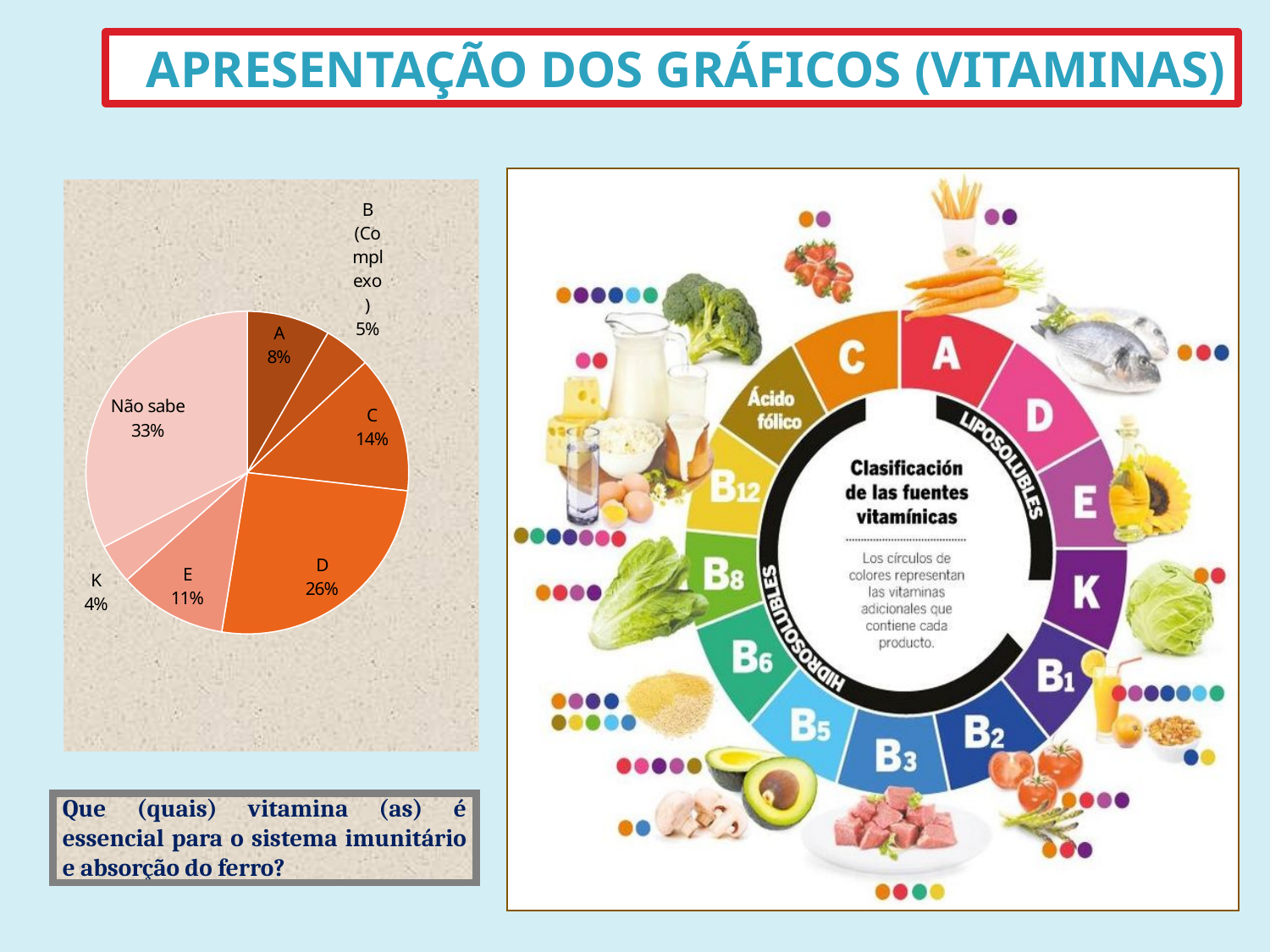
How many slices does the pie chart have? 7 Which slice of the pie chart is the largest? Não sabe In the pie chart, which is larger, the slice for vitamin E or the slice for vitamin A? E Which slice of the pie chart is the smallest? K What kind of chart is shown on the left of the slide? Pie chart In the pie chart, what percentage is shown for B (Complexo)? 5% In the pie chart, what is the difference in percentage points between vitamin D and vitamin C? 12 In the pie chart, what is the difference in percentage points between "Não sabe" and vitamin E? 22 In the pie chart, what percentage is shown for vitamin K? 4% In the pie chart, what percentage is shown for "Não sabe"? 33% In the pie chart, what percentage is shown for vitamin D? 26% In the pie chart, what percentage is shown for vitamin C? 14%